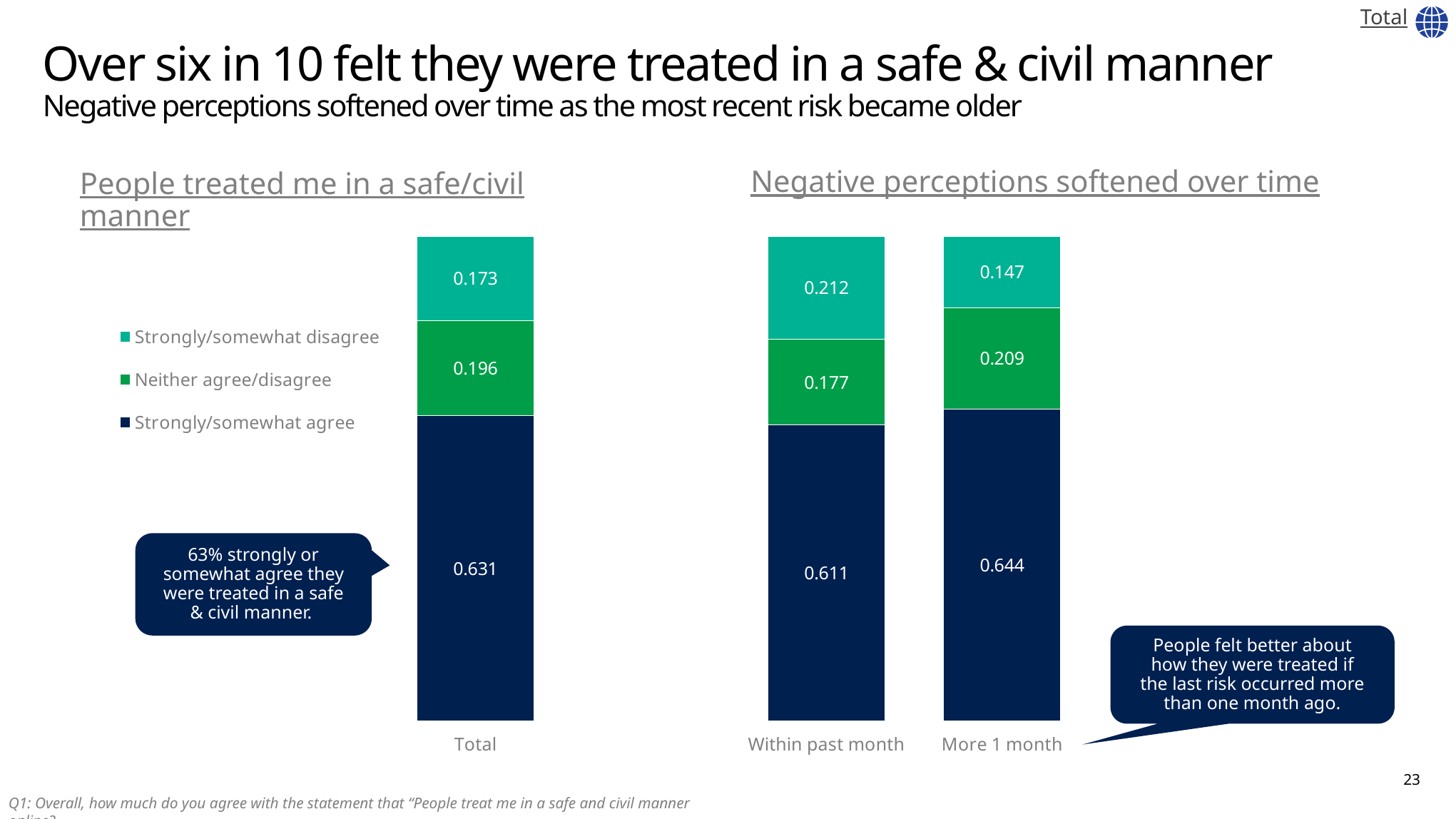
In the chart titled "Negative perceptions softened over time", what is the Neither agree/disagree value for Within past month? 0.177 In the chart titled "People treated me in a safe/civil manner", which series has the largest value in the Total bar? Strongly/somewhat agree In the chart titled "Negative perceptions softened over time", which category has the higher Strongly/somewhat agree value, Within past month or More 1 month? More 1 month What type of chart is the chart titled "Negative perceptions softened over time"? Stacked bar chart In the chart titled "Negative perceptions softened over time", what is the difference between the Strongly/somewhat disagree values for Within past month and More 1 month? 0.065 In the chart titled "Negative perceptions softened over time", what is the Strongly/somewhat agree value for More 1 month? 0.644 In the chart titled "Negative perceptions softened over time", what is the Strongly/somewhat disagree value for Within past month? 0.212 In the chart titled "People treated me in a safe/civil manner", what is the value for Strongly/somewhat disagree? 0.173 In the chart titled "Negative perceptions softened over time", how many categories are shown on the x axis? 2 In the chart titled "People treated me in a safe/civil manner", what is the value for Strongly/somewhat agree in the Total bar? 0.631 In the chart titled "People treated me in a safe/civil manner", what is the value for Neither agree/disagree? 0.196 How many series does the legend on the slide list? 3